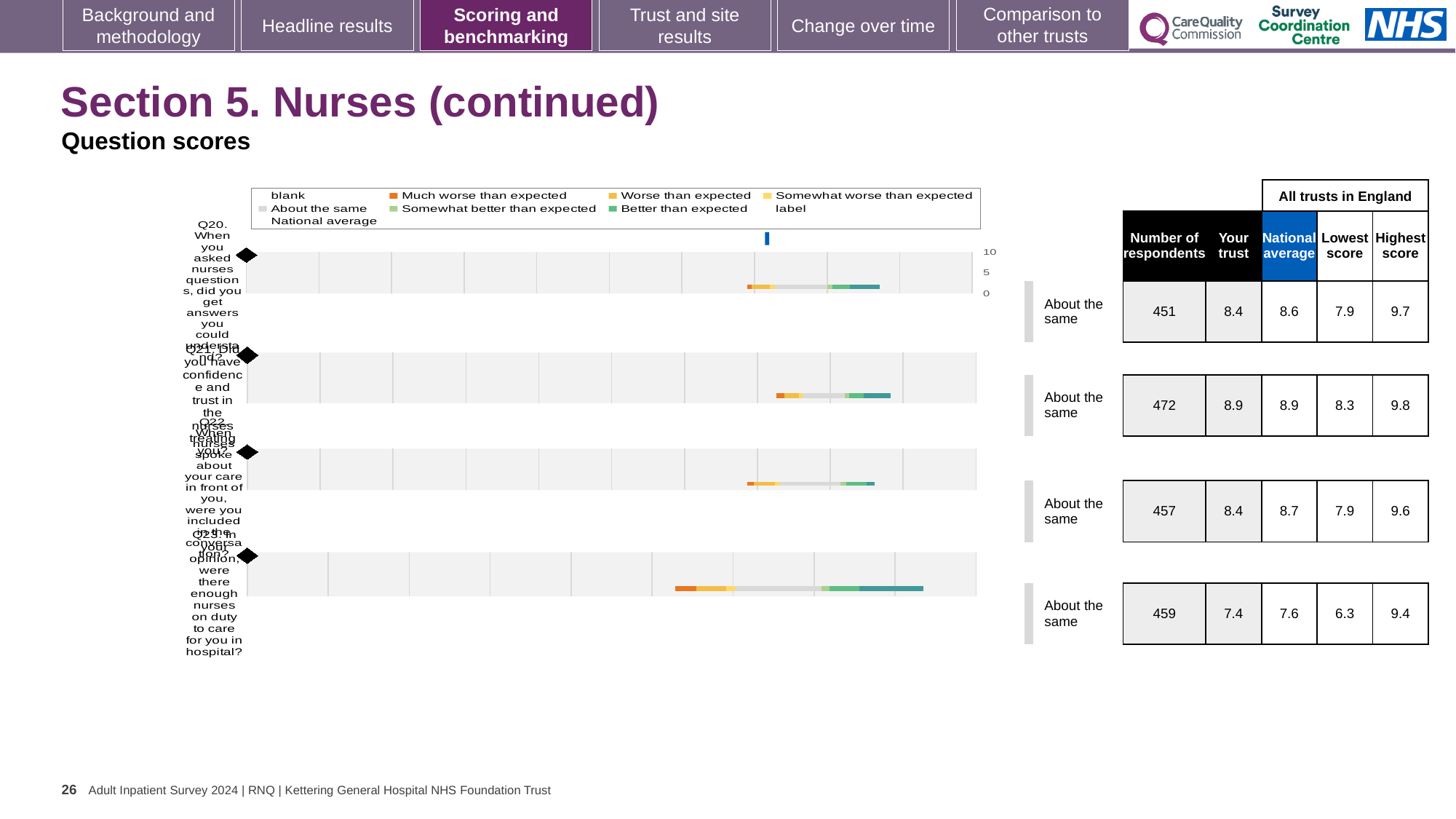
Which question has the highest 'Your trust' score? Q21 How many respondents answered Q20? 451 What is the national average score for Q23 (enough nurses on duty)? 7.6 What does the blue marker in the chart legend represent? National average What benchmark category is shown for Q22 (nurses spoke about your care in front of you)? About the same What kind of chart is used to show the question scores on this slide? bar chart For Q20, which is larger: the 'Your trust' score or the national average? National average What is the difference between the highest score (9.4) and the lowest score (6.3) for Q23? 3.1 What is the 'Your trust' score for Q21 (confidence and trust in the nurses)? 8.9 Which question has the lowest 'Your trust' score? Q23 How many questions (Q20 to Q23) are plotted in the chart? 4 What is the highest score among all trusts in England for Q21? 9.8